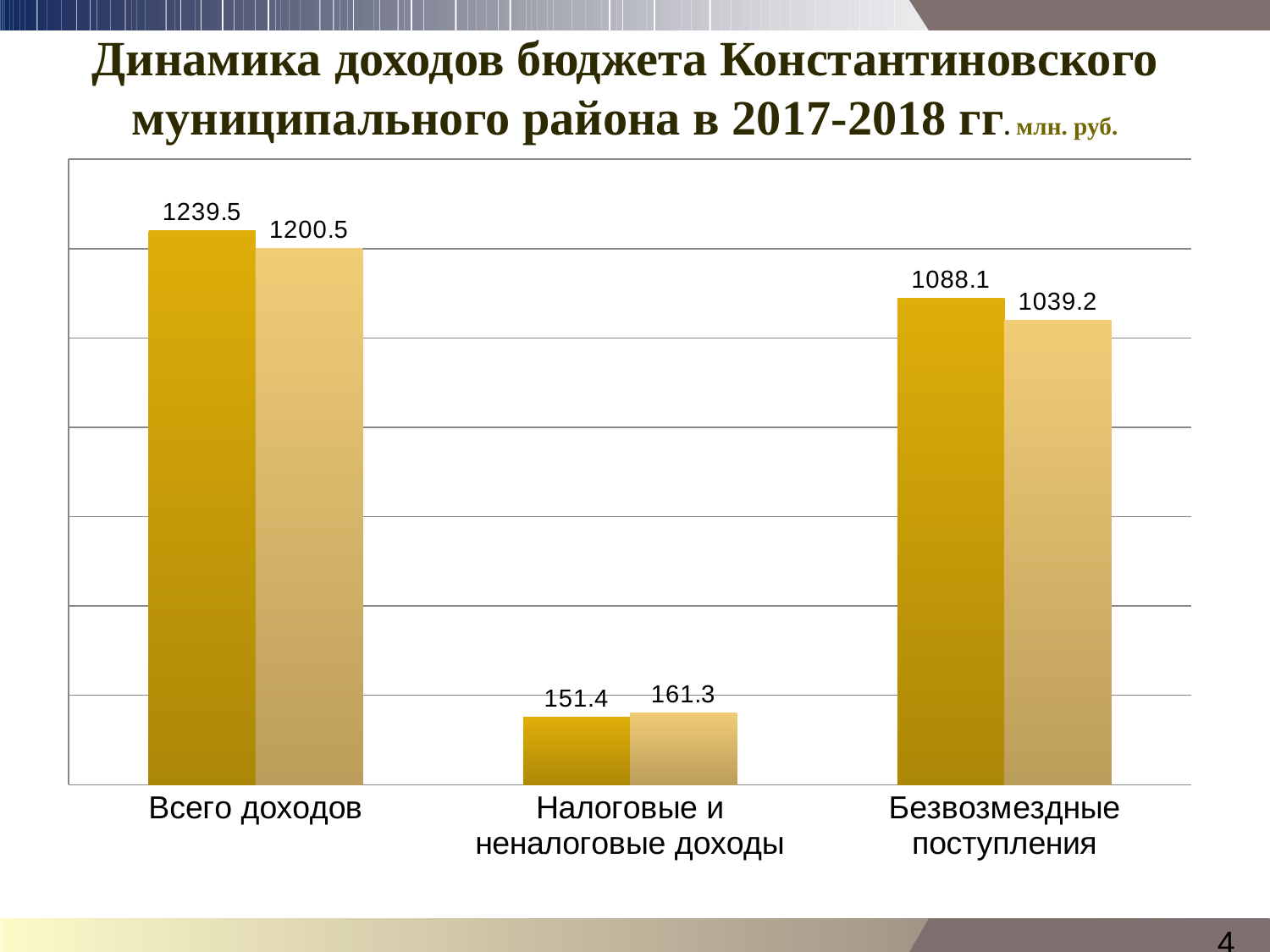
What unit of measurement is stated in the chart title? млн. руб. What is the value of the darker (left) bar for "Налоговые и неналоговые доходы"? 151.4 What is the value of the lighter (right) bar for "Безвозмездные поступления"? 1039.2 What is the value of the lighter (right) bar for "Всего доходов"? 1200.5 What type of chart is shown on the slide? Bar chart What is the value of the darker (left) bar for "Всего доходов"? 1239.5 What is the difference between the two bars for "Всего доходов" (1239.5 and 1200.5)? 39.0 For "Налоговые и неналоговые доходы", which bar is larger: the darker (left) bar or the lighter (right) bar? The lighter (right) bar What is the difference between the two bars for "Безвозмездные поступления" (1088.1 and 1039.2)? 48.9 Which category has the lowest values in the chart? Налоговые и неналоговые доходы Which category has the highest values in the chart? Всего доходов How many categories are shown on the x axis of the chart? 3